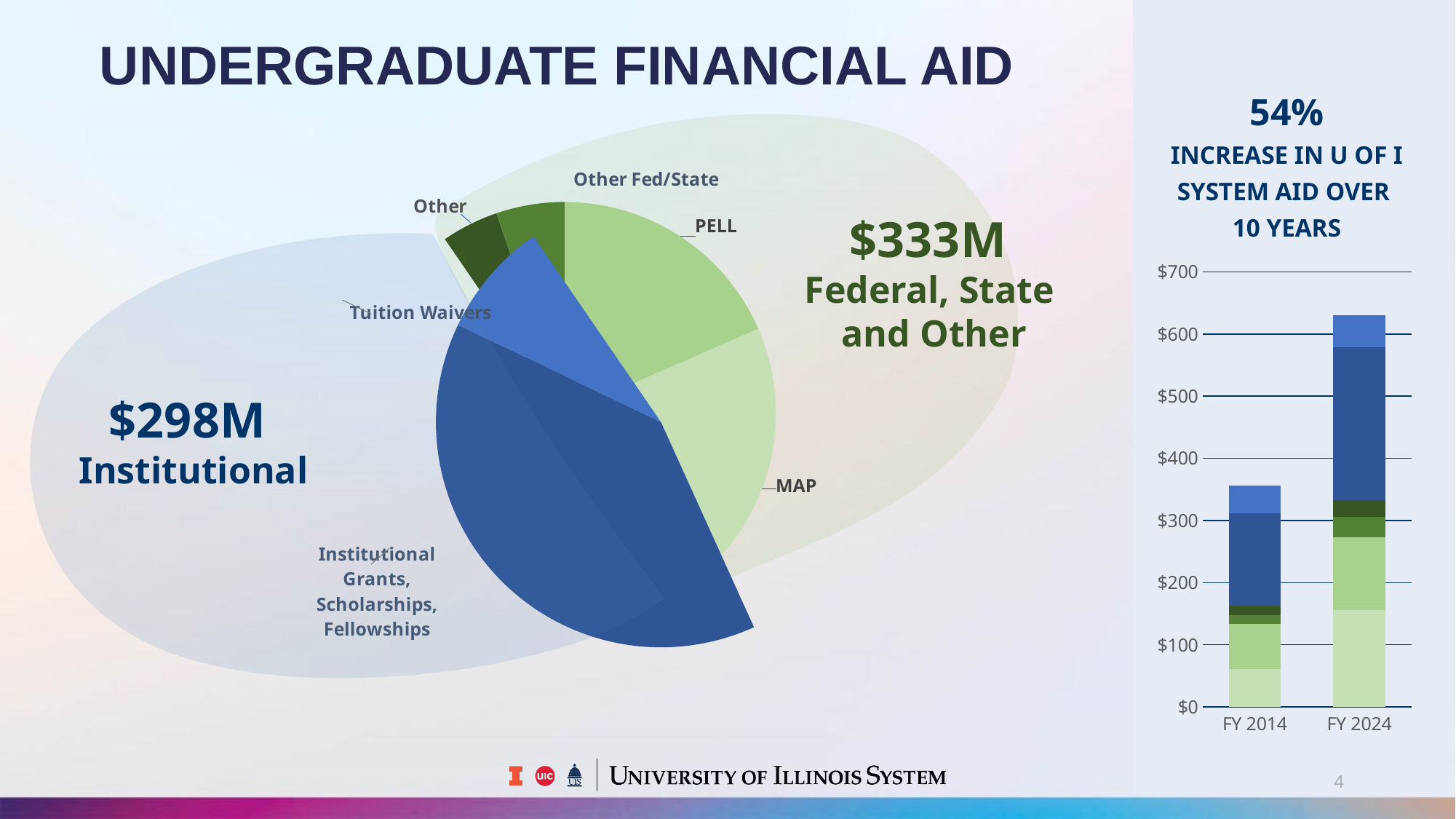
In the bar chart on the right, is the total for FY 2014 greater or less than $300? greater In the bar chart on the right, which year has the taller bar, FY 2014 or FY 2024? FY 2024 What kind of chart is the chart on the right of the slide? stacked bar chart What kind of chart is the chart on the left of the slide? pie chart How many fiscal years are shown on the x axis of the bar chart on the right? 2 In the pie chart on the left, which slice is larger, PELL or MAP? MAP What percentage increase in U of I System aid over 10 years is stated above the bar chart on the right? 54% How many slices does the pie chart on the left have? 6 In the bar chart on the right, does total aid rise or fall from FY 2014 to FY 2024? rise In the pie chart on the left, which slice is the largest? Institutional Grants, Scholarships, Fellowships In the pie chart on the left, which slice is larger, Tuition Waivers or PELL? PELL In the bar chart on the right, is the total for FY 2024 greater or less than $600? greater